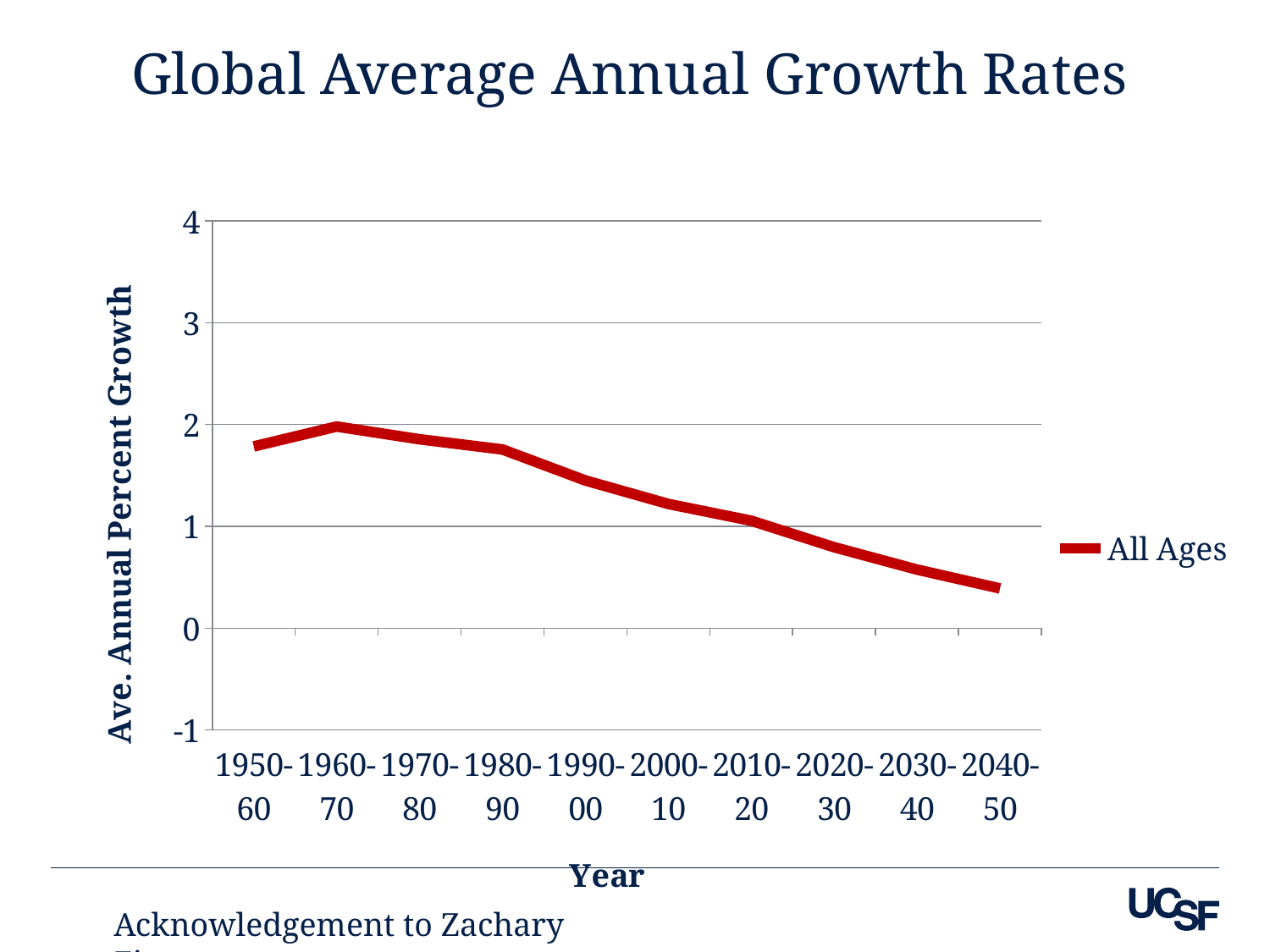
How many series does the legend list? 1 Is the value for 1960-70 greater or less than 3? less Do the values generally rise or fall from 1960-70 to 2040-50? fall What kind of chart is shown on the slide? Line chart What is the name of the series shown in the legend? All Ages Which period has the lowest average annual percent growth? 2040-50 Is the value for 1950-60 greater or less than 1? greater Which is larger, the value for 1950-60 or the value for 2030-40? 1950-60 Is the value for 2040-50 greater or less than 1? less How many time periods are plotted along the x axis? 10 What is the title of the chart? Global Average Annual Growth Rates Which period has the highest average annual percent growth? 1960-70